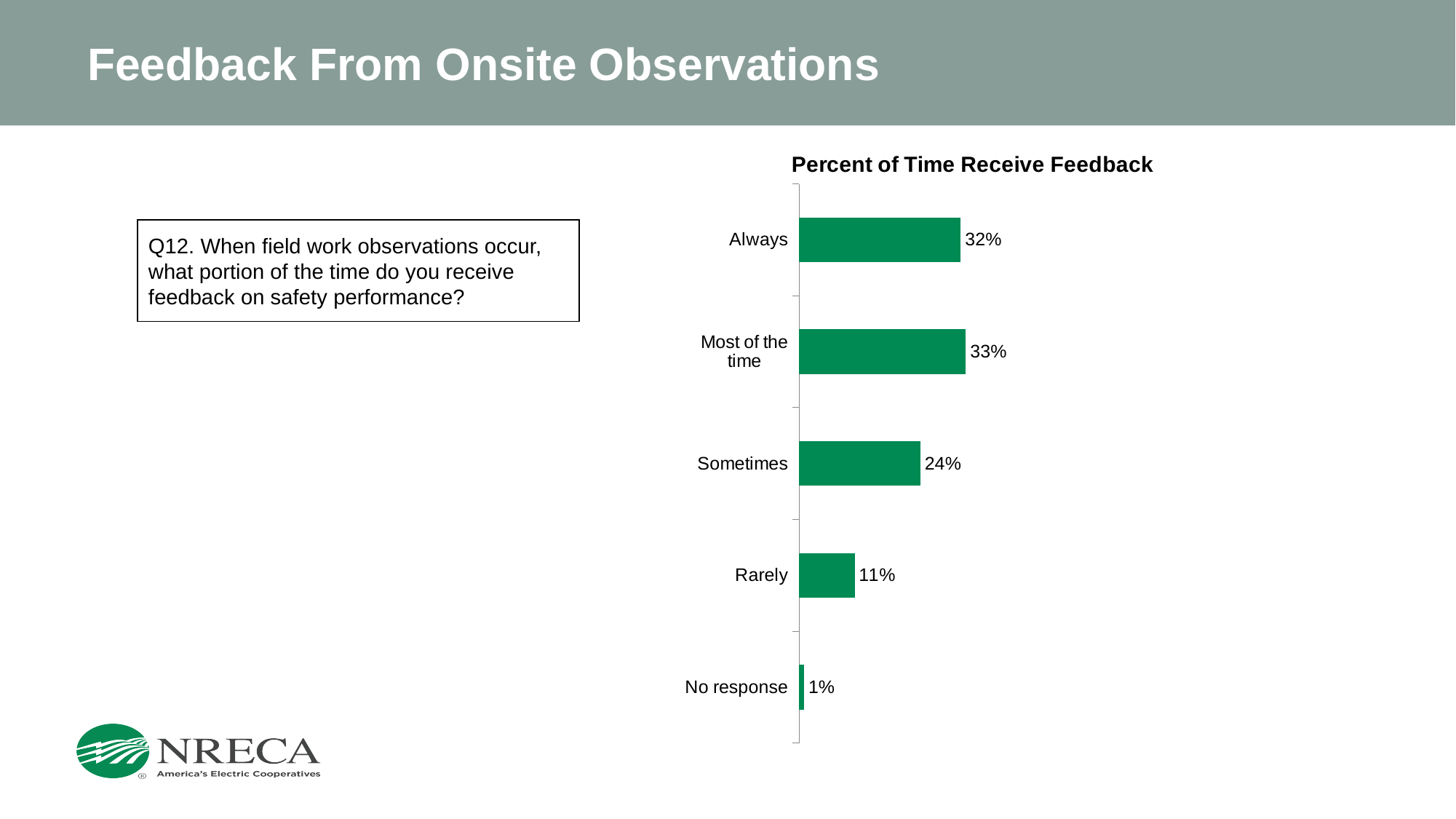
Which category has the highest value? Most of the time What is the value for "Sometimes"? 24% Which category has the lowest value? No response What is the title of the chart? Percent of Time Receive Feedback What is the difference between the values for "Sometimes" and "Rarely"? 13% What is the value for "Most of the time"? 33% Which is larger, the value for "Always" or the value for "Sometimes"? Always What is the value for "No response"? 1% What is the value for "Always"? 32% How many categories are shown in the chart? 5 What is the value for "Rarely"? 11% What kind of chart is shown on the slide? Bar chart